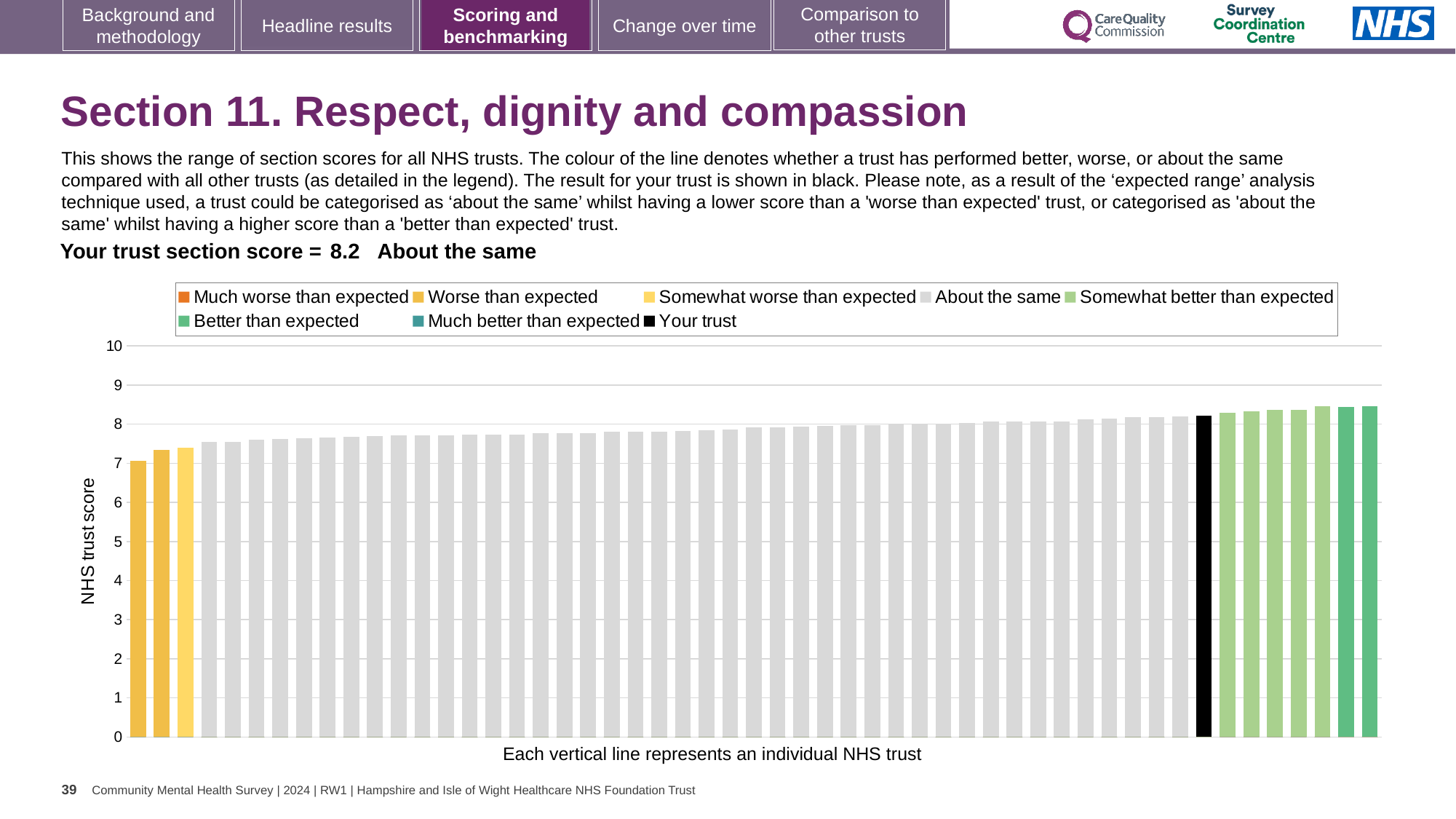
Is the value of the leftmost (lowest) bar greater or less than 8? less Which performance category is your trust placed in for this section? About the same What is the label on the vertical axis of the chart? NHS trust score What is the section score for your trust? 8.2 How many entries does the chart legend list? 8 How many bars are coloured as 'Somewhat better than expected'? 5 Which is larger: the score of your trust or the score of the leftmost bar? your trust What colour is the bar representing your trust? black Is the value of the rightmost (highest) bar greater or less than 9? less How many bars are coloured as 'Worse than expected'? 2 Do the bar values rise or fall moving from left to right along the x axis? rise What kind of chart is shown on the slide? bar chart